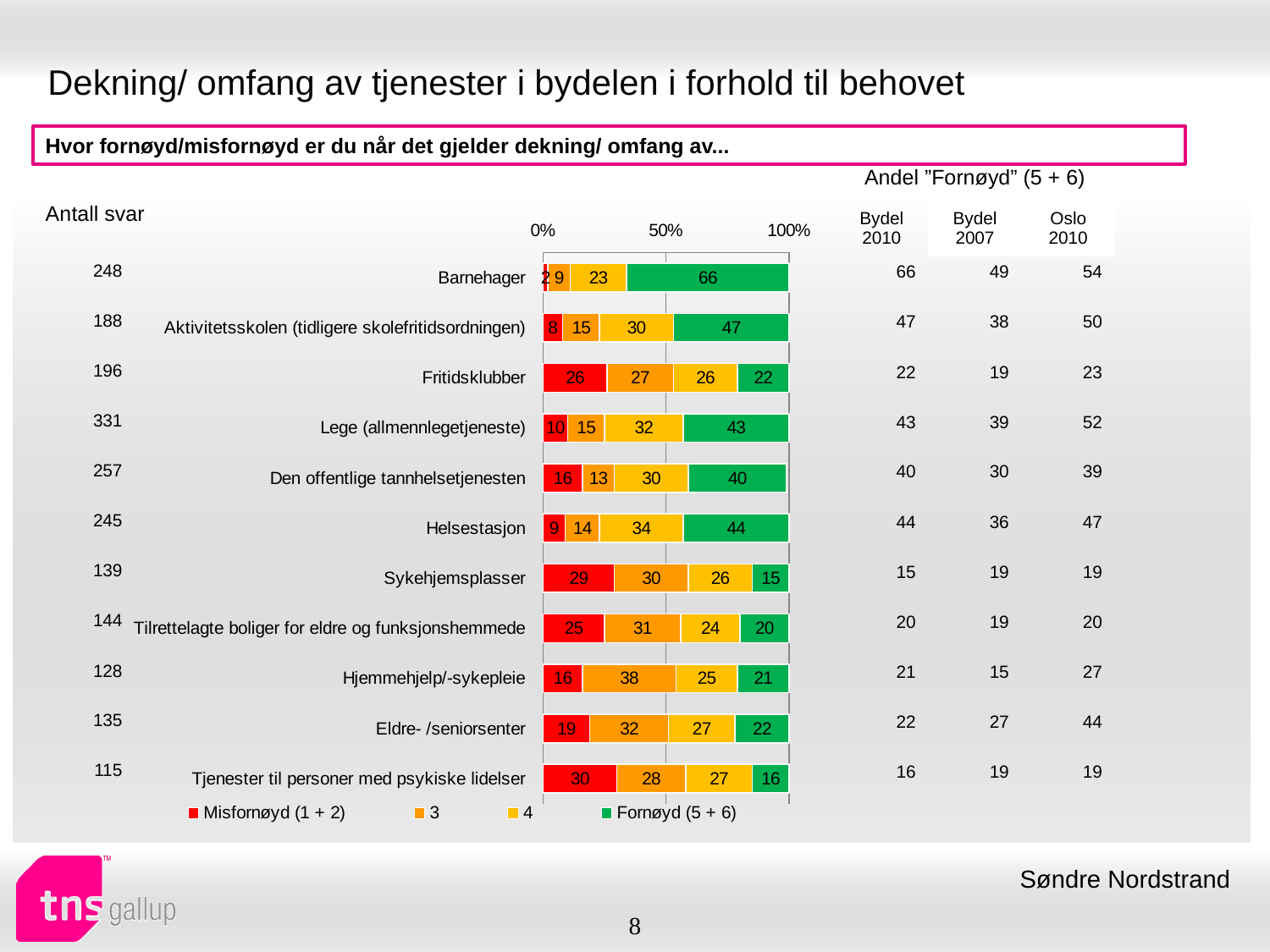
Which category has the highest "Fornøyd (5 + 6)" value? Barnehager What kind of chart is shown on the slide? Stacked bar chart How many series does the legend list? 4 What is the difference between the "Fornøyd (5 + 6)" values for Barnehager and Fritidsklubber? 44 Which category has the lowest "Misfornøyd (1 + 2)" value? Barnehager What is the value of "Fornøyd (5 + 6)" for Barnehager? 66 Which category has the highest value for series "3"? Hjemmehjelp/-sykepleie How many categories are shown in the chart? 11 Which has a larger "Fornøyd (5 + 6)" value, Aktivitetsskolen (tidligere skolefritidsordningen) or Fritidsklubber? Aktivitetsskolen (tidligere skolefritidsordningen) What is the value of series "4" for Helsestasjon? 34 What is the value of series "3" for Eldre- /seniorsenter? 32 What is the value of "Misfornøyd (1 + 2)" for Sykehjemsplasser? 29